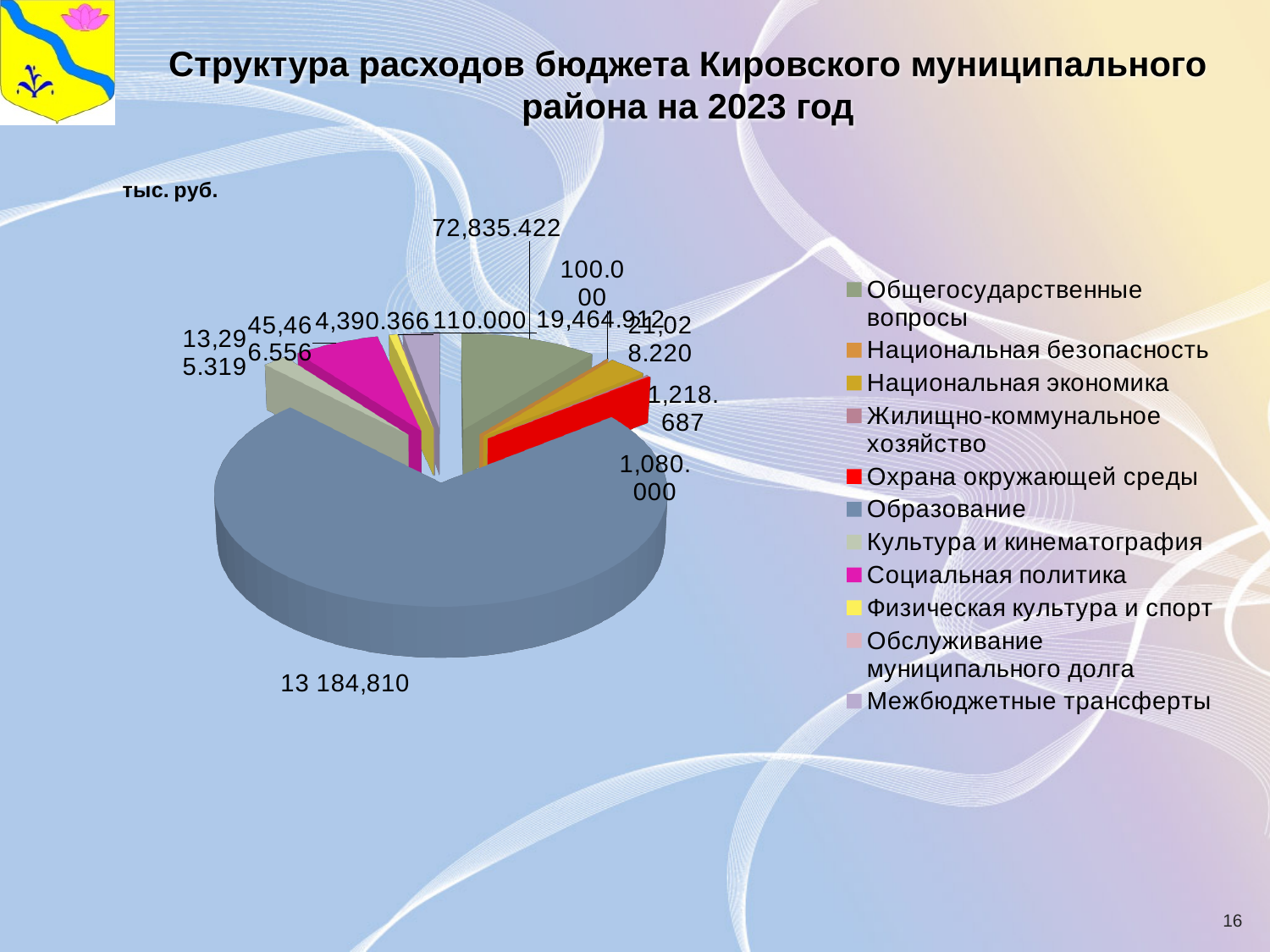
In what units are the values of the chart given? тыс. руб. What is the value shown for Культура и кинематография? 13,295.319 What is the value shown for Общегосударственные вопросы? 72,835.422 What is the value shown for Социальная политика? 45,466.556 How many categories does the legend of the pie chart list? 11 What is the value shown for Образование? 13 184,810 What is the title of the chart on the slide? Структура расходов бюджета Кировского муниципального района на 2023 год What kind of chart is shown on the slide? pie chart What is the value shown for Охрана окружающей среды? 1,080.000 What is the difference between the values for Общегосударственные вопросы and Социальная политика? 27,368.866 Which is larger, the slice for Общегосударственные вопросы or the slice for Социальная политика? Общегосударственные вопросы Which category has the largest slice in the pie chart? Образование